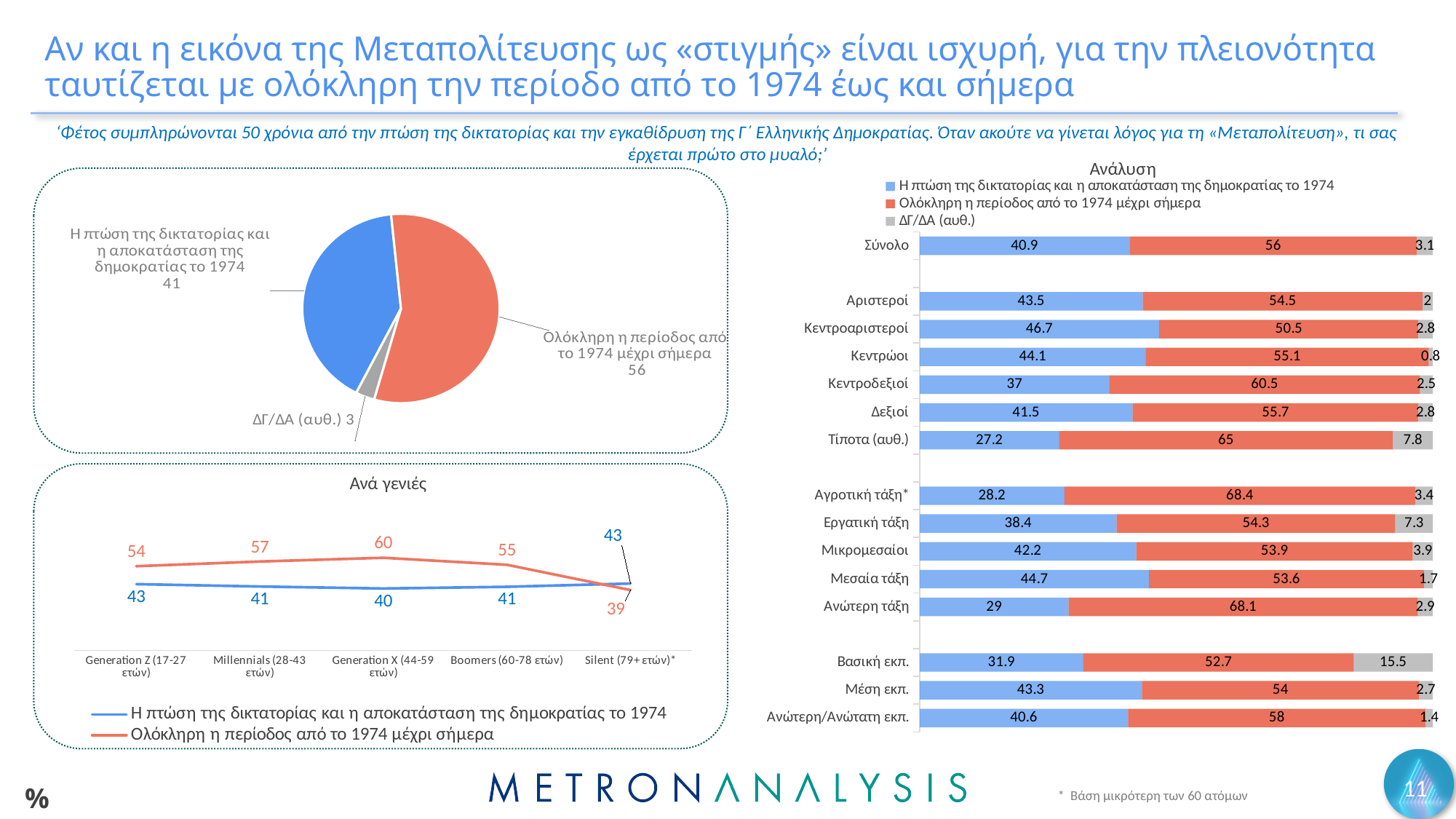
In the 'Ανάλυση' chart on the right, what is the difference between the 'Η πτώση της δικτατορίας και η αποκατάσταση της δημοκρατίας το 1974' values for Κεντροαριστεροί and Κεντροδεξιοί? 9.7 In the 'Ανά γενιές' chart, how many generation categories are shown on the x axis? 5 In the 'Ανάλυση' chart on the right, how many series does the legend list? 3 In the 'Ανάλυση' chart on the right, which category has the lowest value for 'Η πτώση της δικτατορίας και η αποκατάσταση της δημοκρατίας το 1974'? Τίποτα (αυθ.) In the 'Ανάλυση' chart on the right, what is the value of 'Ολόκληρη η περίοδος από το 1974 μέχρι σήμερα' for Αγροτική τάξη*? 68.4 In the 'Ανά γενιές' chart, which series has the higher value for Silent (79+ ετών)? Η πτώση της δικτατορίας και η αποκατάσταση της δημοκρατίας το 1974 What kind of chart is the 'Ανά γενιές' chart on the bottom left? Line chart In the pie chart on the top left, which slice is the smallest? ΔΓ/ΔΑ (αυθ.) In the 'Ανάλυση' chart on the right, which category has the highest value for 'ΔΓ/ΔΑ (αυθ.)'? Βασική εκπ. In the 'Ανά γενιές' chart, what is the difference between the two series for Boomers (60-78 ετών)? 14 In the 'Ανά γενιές' chart, what is the value of 'Ολόκληρη η περίοδος από το 1974 μέχρι σήμερα' for Generation X (44-59 ετών)? 60 In the pie chart on the top left, what value is shown for the slice 'Ολόκληρη η περίοδος από το 1974 μέχρι σήμερα'? 56